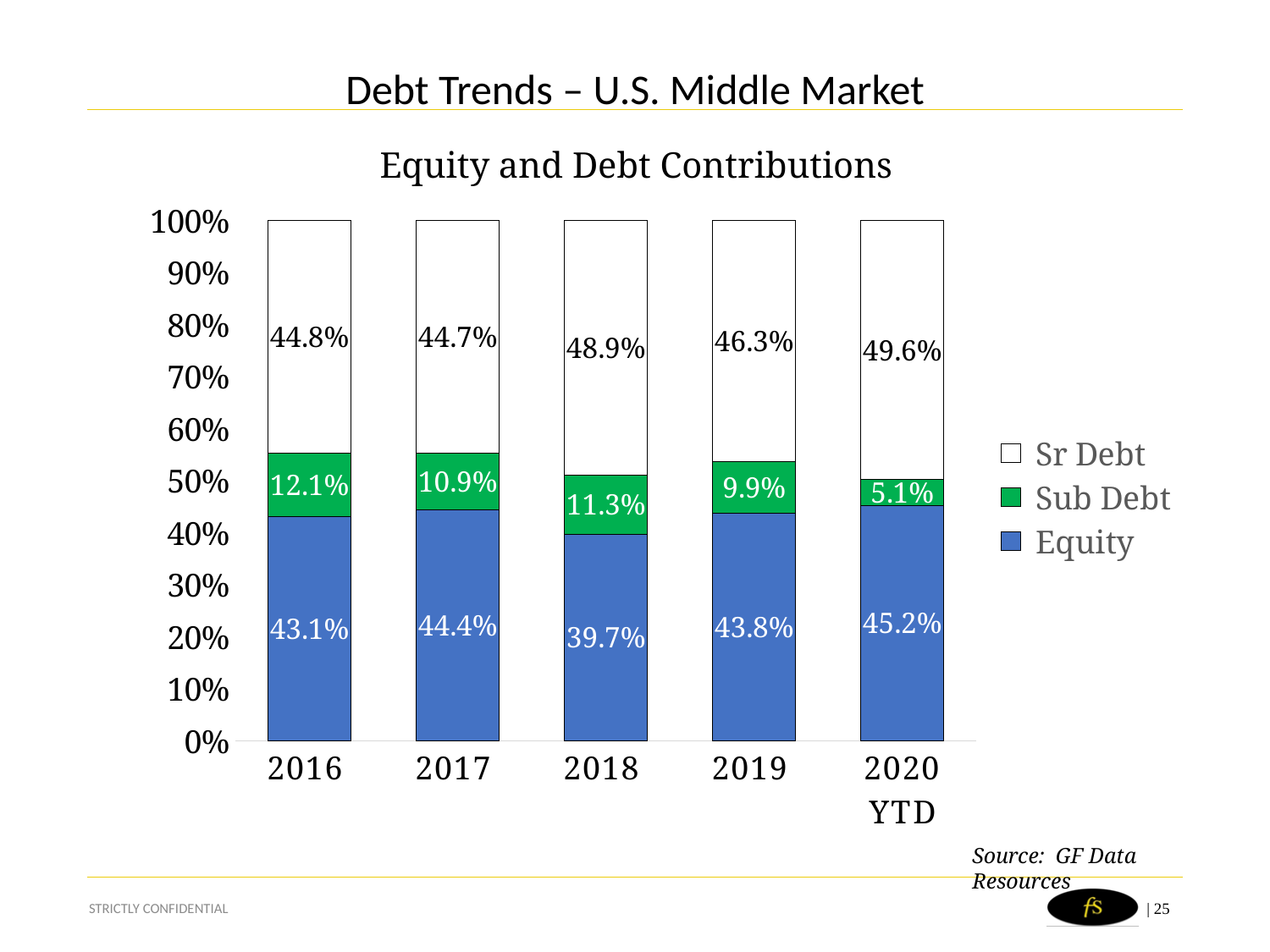
Which year has the lowest Sub Debt contribution? 2020 YTD What is the Sub Debt contribution for 2017? 10.9% What is the difference between the Sr Debt contribution in 2020 YTD and in 2016? 4.8% What kind of chart is shown? Stacked bar chart Which year has the lowest Equity contribution? 2018 What is the title of the chart? Equity and Debt Contributions What is the Equity contribution for 2018? 39.7% Which is larger, the Equity contribution in 2017 or in 2019? 2017 What is the Sr Debt contribution for 2020 YTD? 49.6% How many years are shown on the x axis? 5 Which year has the highest Sub Debt contribution? 2016 How many series does the legend list? 3